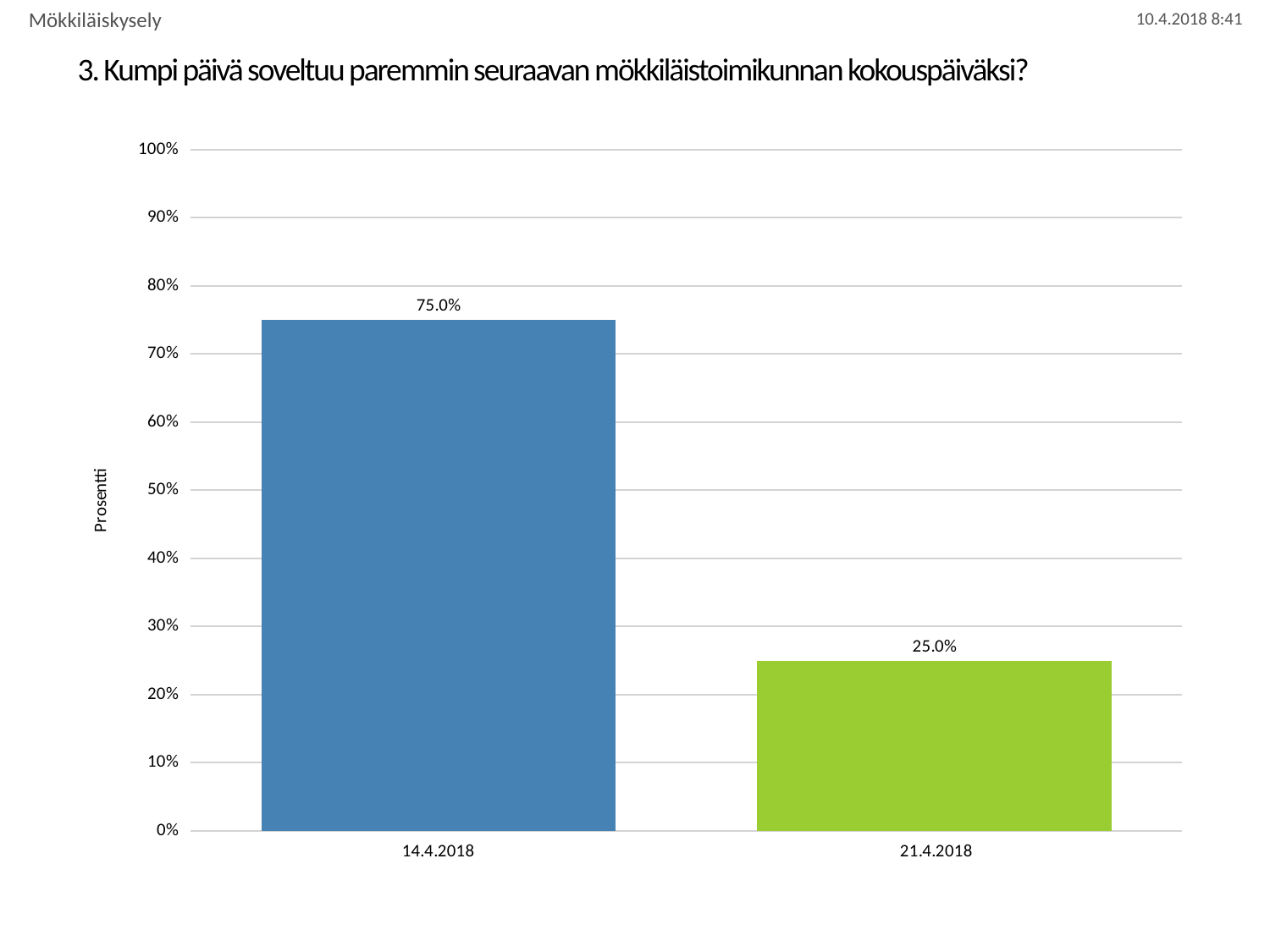
What is the value for 21.4.2018? 25.0% How many categories are shown on the x axis? 2 Is the value for 21.4.2018 greater or less than 30%? less What is the label of the vertical axis? Prosentti Which is larger, the value for 14.4.2018 or for 21.4.2018? 14.4.2018 Which date has the lowest value? 21.4.2018 What colour is the bar for 21.4.2018? green Which date has the highest value? 14.4.2018 What is the difference between the values for 14.4.2018 and 21.4.2018? 50.0% What is the value for 14.4.2018? 75.0% Is the value for 14.4.2018 greater or less than 70%? greater What kind of chart is shown on the slide? bar chart